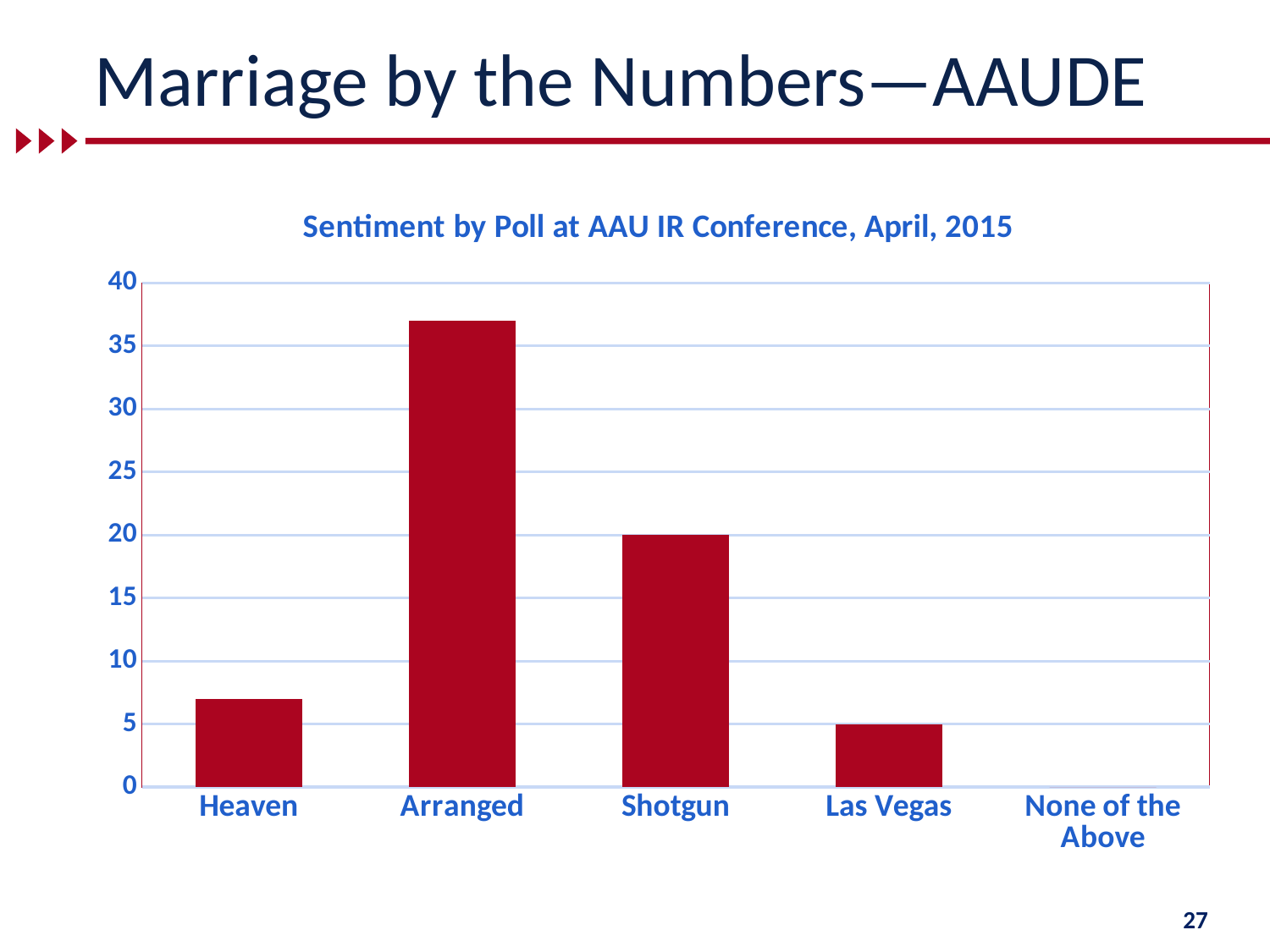
What is the value for Las Vegas? 5 Is the value for Heaven greater or less than 10? less What is the value for Shotgun? 20 Which category has the highest value? Arranged How many categories are shown on the x axis of the chart? 5 Which is larger, the value for Heaven or the value for Arranged? Arranged What is the difference between the values for Shotgun and Las Vegas? 15 What type of chart is shown on the slide? bar chart What is the title of the chart? Sentiment by Poll at AAU IR Conference, April, 2015 Which is larger, the value for Shotgun or the value for Las Vegas? Shotgun Which category has the lowest value? None of the Above Is the value for Arranged greater or less than 35? greater